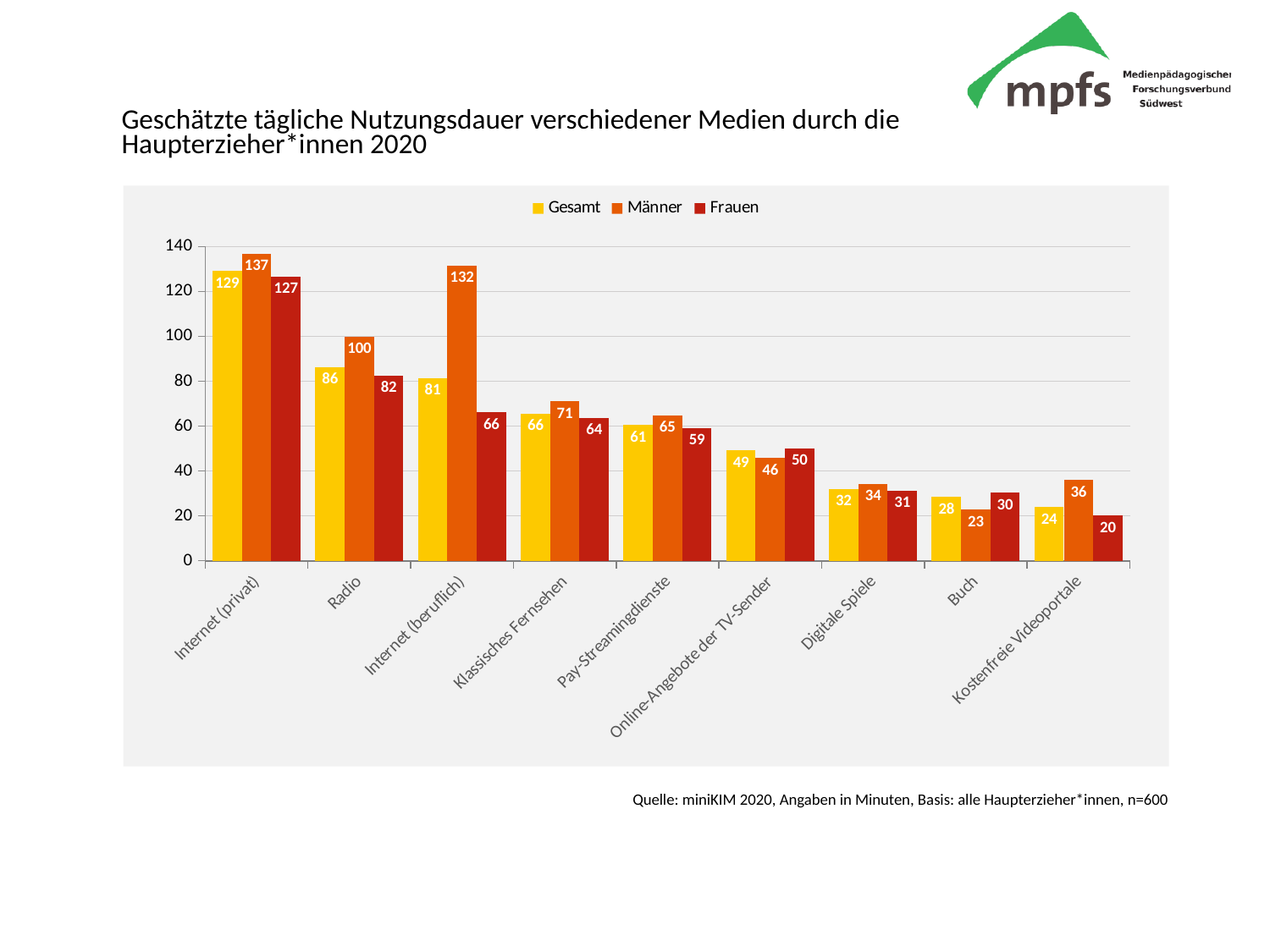
Which category has the highest Gesamt value? Internet (privat) How many media categories are shown on the x axis? 9 What is the Frauen value for Kostenfreie Videoportale? 20 Which series is shown in yellow in the legend? Gesamt Which category has the lowest Frauen value? Kostenfreie Videoportale What is the difference between the Männer and Frauen values for Internet (beruflich)? 66 Is the Männer value for Radio greater or less than 80? greater What is the Gesamt value for Radio? 86 What is the Männer value for Internet (beruflich)? 132 What kind of chart is shown on the slide? bar chart How many series does the legend list? 3 Which is larger for Buch: the Männer value or the Frauen value? Frauen